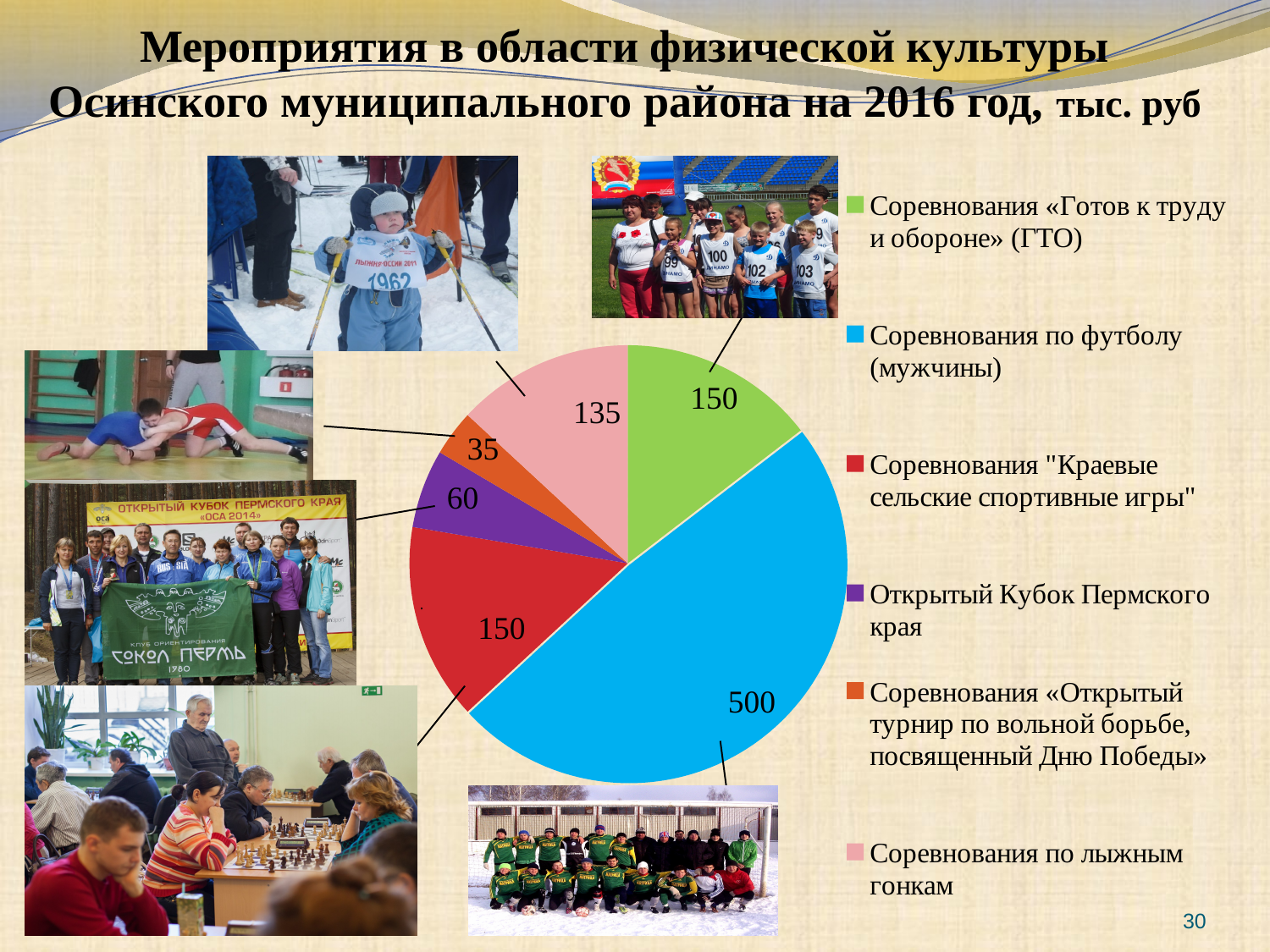
What is the value for «Открытый Кубок Пермского края»? 60 What is the difference between the value for «Соревнования по футболу (мужчины)» and the value for «Соревнования "Краевые сельские спортивные игры"»? 350 Which category has the smallest slice of the pie? Соревнования «Открытый турнир по вольной борьбе, посвященный Дню Победы» What is the value for «Соревнования по футболу (мужчины)» in the pie chart? 500 What is the value for «Соревнования по лыжным гонкам»? 135 What type of chart is shown on the slide? pie chart What is the value for «Соревнования «Открытый турнир по вольной борьбе, посвященный Дню Победы»»? 35 How many slices does the pie chart have? 6 Which category has the largest slice of the pie? Соревнования по футболу (мужчины) What is the total of all the values shown in the pie chart? 1030 Which is larger: the value for «Соревнования по лыжным гонкам» or the value for «Открытый Кубок Пермского края»? Соревнования по лыжным гонкам What is the value for «Соревнования «Готов к труду и обороне» (ГТО)»? 150